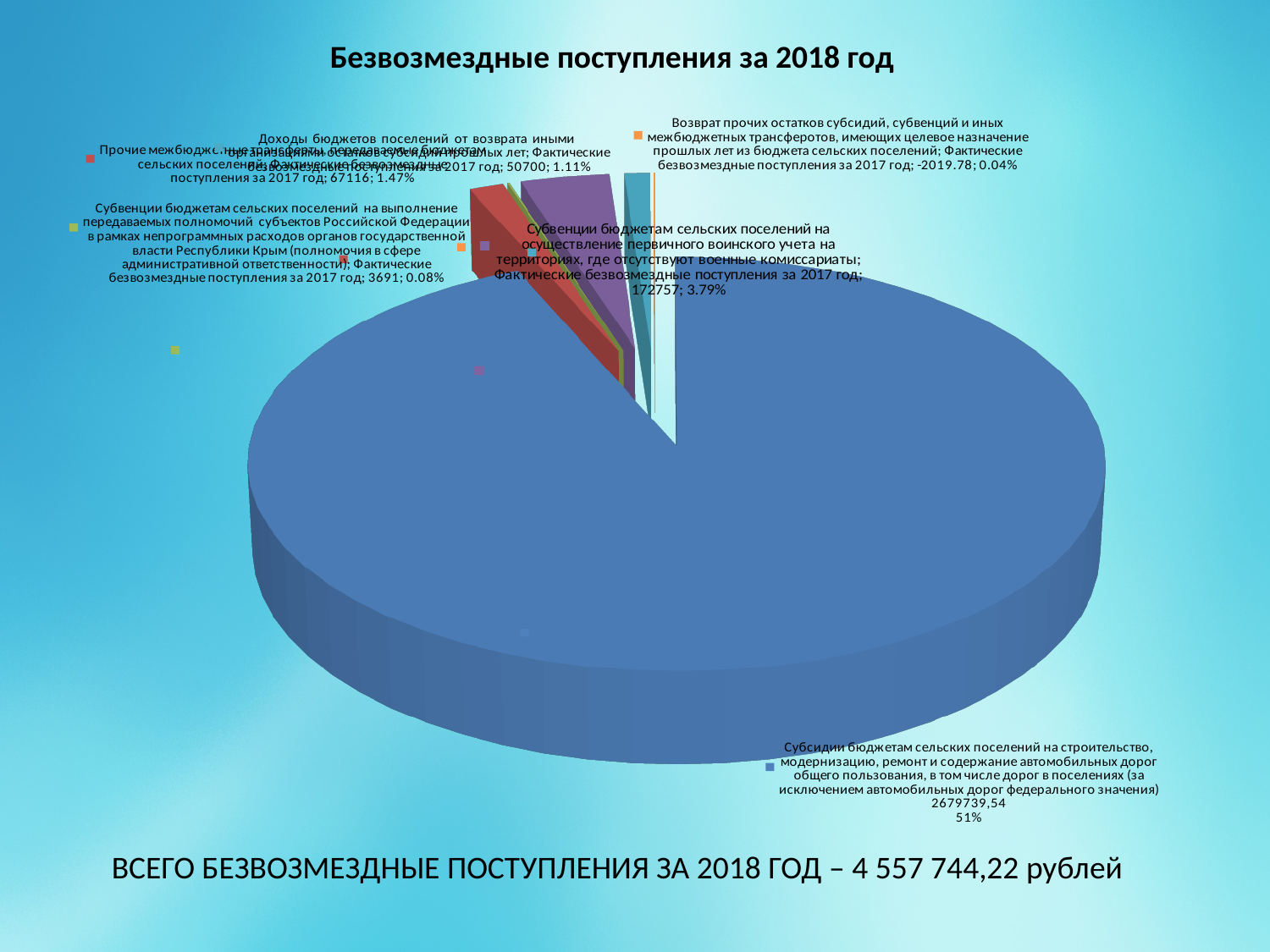
What share of the pie does the slice for subsidies for roads (Субсидии бюджетам сельских поселений на строительство... автомобильных дорог) represent? 51% What kind of chart is shown on the slide? pie chart Which is larger: the value for 'Субвенции ... первичного воинского учета' or the value for 'Прочие межбюджетные трансферты'? Субвенции ... первичного воинского учета What value is shown for 'Возврат прочих остатков субсидий, субвенций и иных межбюджетных трансфертов'? -2019.78 What percentage is shown for 'Субвенции бюджетам сельских поселений на осуществление первичного воинского учета'? 3.79% What is the difference between the value for 'Субвенции ... первичного воинского учета' (172757) and 'Прочие межбюджетные трансферты' (67116)? 105641 What is the title of the chart? Безвозмездные поступления за 2018 год What percentage is shown for 'Доходы бюджетов поселений от возврата иными организациями остатков субсидий прошлых лет'? 1.11% Which category has the largest slice of the pie? Субсидии бюджетам сельских поселений на строительство, модернизацию, ремонт и содержание автомобильных дорог общего пользования What value is shown for 'Прочие межбюджетные трансферты, передаваемые бюджетам сельских поселений'? 67116 What value is shown for the slice 'Субсидии бюджетам сельских поселений на строительство, модернизацию, ремонт и содержание автомобильных дорог общего пользования'? 2679739,54 What value is shown for 'Субвенции бюджетам сельских поселений на осуществление первичного воинского учета'? 172757